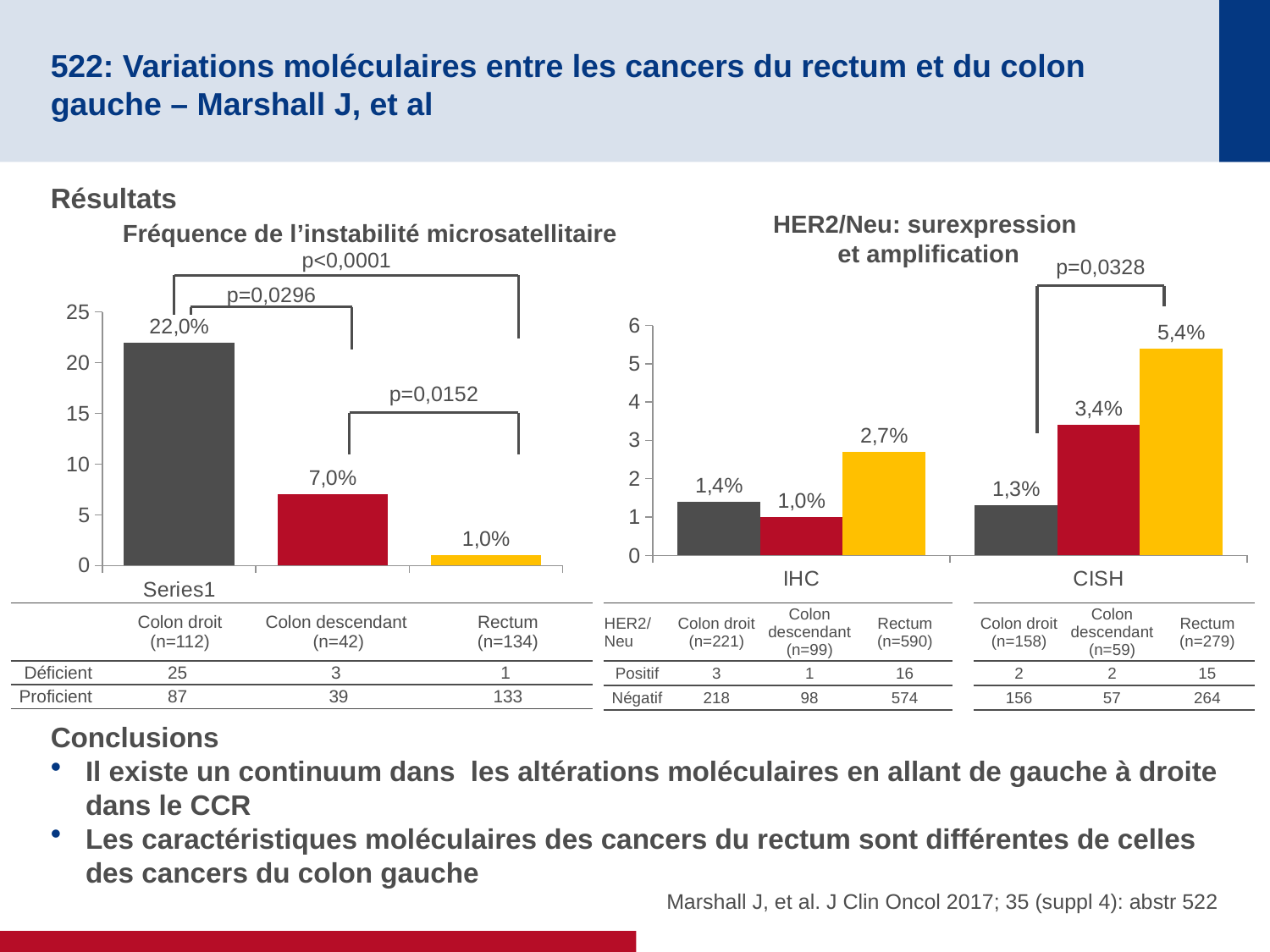
In the chart 'HER2/Neu: surexpression et amplification', what is the difference between the yellow bar in CISH (5,4%) and the yellow bar in IHC (2,7%)? 2,7% In the chart 'HER2/Neu: surexpression et amplification', what value is labelled on the red bar in the CISH group? 3,4% In the chart 'Fréquence de l'instabilité microsatellitaire', what value is labelled on the tallest (dark grey) bar? 22,0% In the chart 'Fréquence de l'instabilité microsatellitaire', what value is labelled on the red bar? 7,0% In the chart 'Fréquence de l'instabilité microsatellitaire', do the bar values rise or fall from left to right? fall In the chart 'Fréquence de l'instabilité microsatellitaire', what p-value is shown between the first and third bars? p<0,0001 In the chart 'Fréquence de l'instabilité microsatellitaire', what value is labelled on the yellow bar? 1,0% What kind of chart is 'HER2/Neu: surexpression et amplification'? bar chart In the chart 'HER2/Neu: surexpression et amplification', which bar has the highest value? The yellow bar in the CISH group (5,4%) In the chart 'Fréquence de l'instabilité microsatellitaire', what is the difference between the dark grey bar (22,0%) and the red bar (7,0%)? 15,0% In the chart 'HER2/Neu: surexpression et amplification', which is larger: the dark grey bar in IHC (1,4%) or the dark grey bar in CISH (1,3%)? IHC (1,4%) In the chart 'HER2/Neu: surexpression et amplification', what value is labelled on the yellow bar in the IHC group? 2,7%